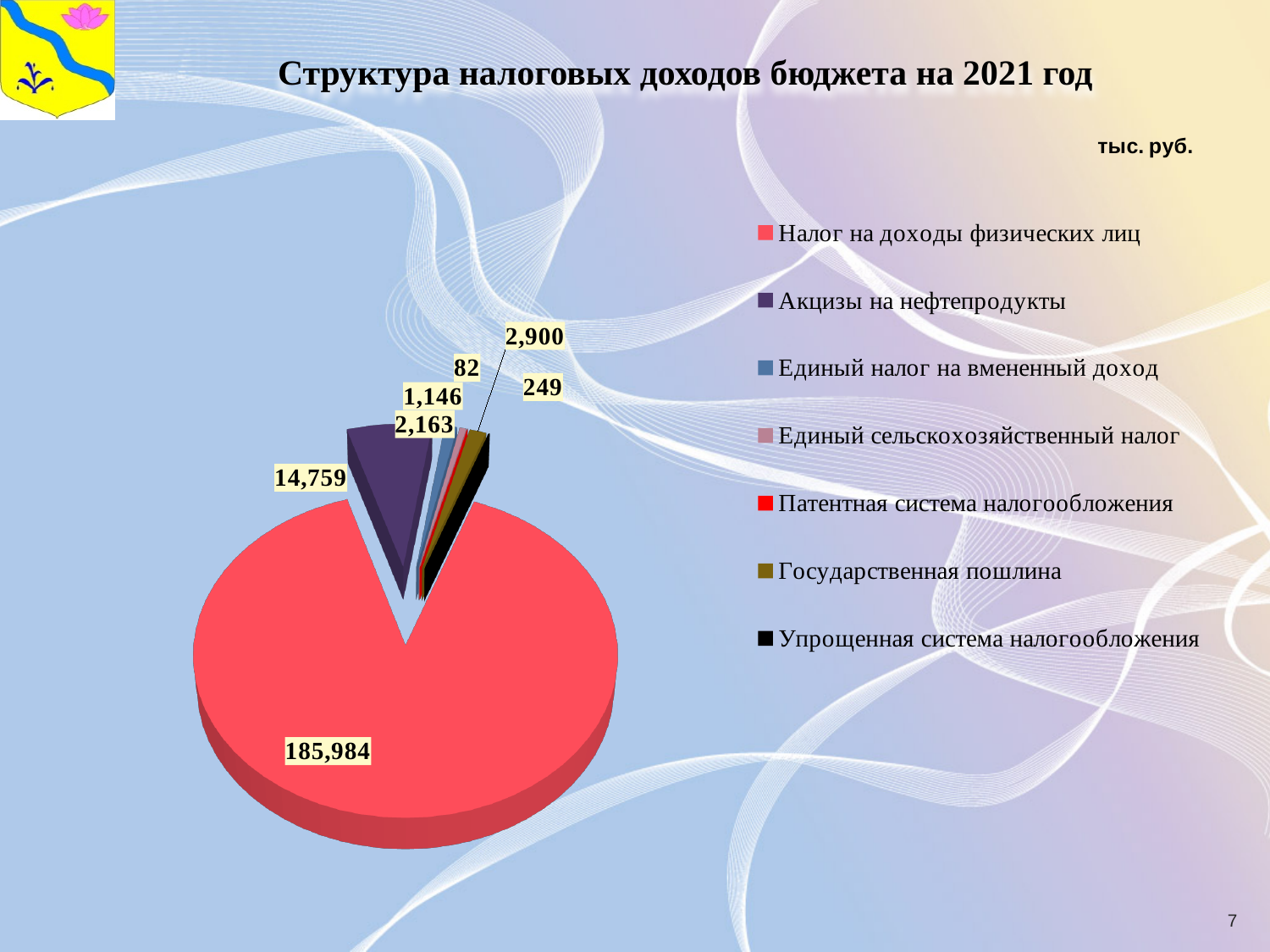
What is the value for Акцизы на нефтепродукты? 14,759 What unit of measurement is indicated for the chart values? тыс. руб. Which is larger: Единый налог на вмененный доход or Упрощенная система налогообложения? Единый налог на вмененный доход What kind of chart is shown on the slide? Pie chart What is the value for Единый налог на вмененный доход? 2,163 How many categories does the pie chart have? 7 What is the value for Налог на доходы физических лиц? 185,984 What is the value for Государственная пошлина? 2,900 Which category has the largest slice of the pie? Налог на доходы физических лиц What is the value for Упрощенная система налогообложения? 249 Which category has the smallest value? Патентная система налогообложения What is the difference between Акцизы на нефтепродукты and Единый налог на вмененный доход? 12,596